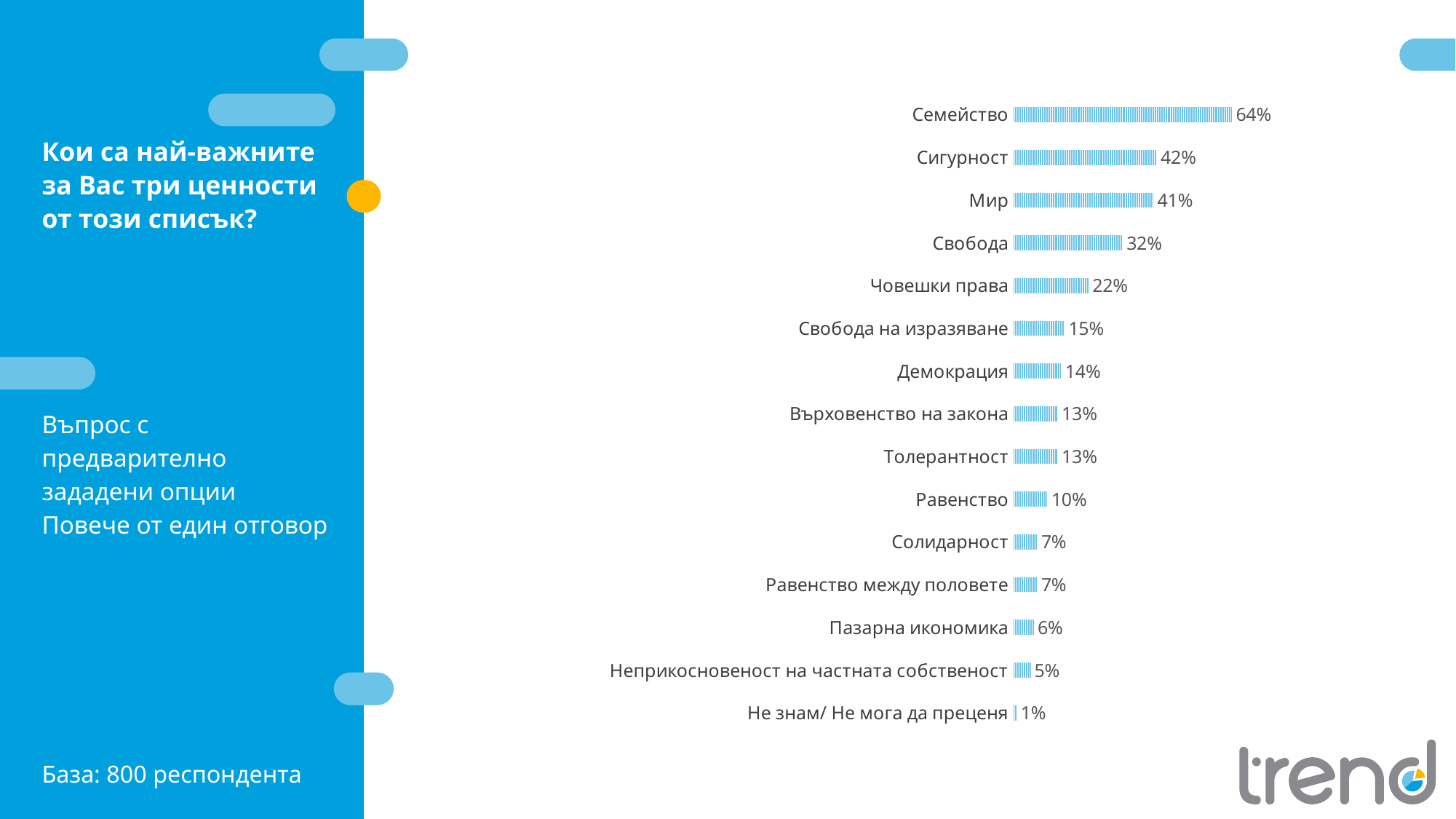
What is the value for Свобода? 32% Which category has the highest value? Семейство What is the value for Неприкосновеност на частната собственост? 5% What kind of chart is shown on the slide? Bar chart How many categories are shown in the chart? 15 Which is larger, the value for Мир or the value for Свобода? Мир What is the value for Семейство? 64% Which category has the lowest value? Не знам/ Не мога да преценя What is the difference between the values for Семейство and Сигурност? 22% What is the difference between the values for Човешки права and Равенство? 12% Which is larger, the value for Солидарност or the value for Равенство? Равенство What is the value for Демокрация? 14%